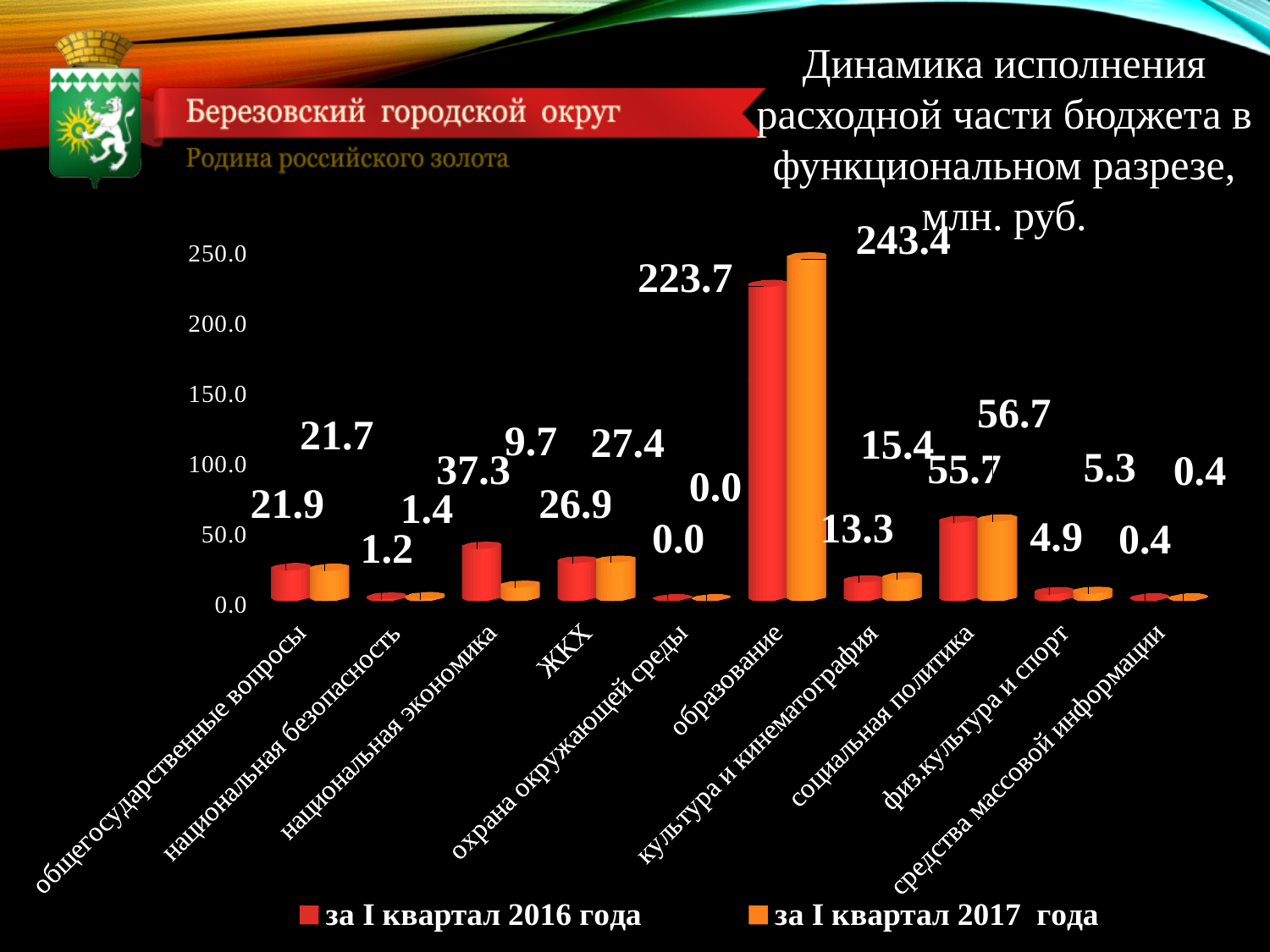
What is the difference between the за I квартал 2017 года and за I квартал 2016 года values for образование? 19.7 Is the value for социальная политика for за I квартал 2016 года greater or less than 100.0? less What is the value for социальная политика for за I квартал 2017 года? 56.7 How many series does the legend list? 2 Which category has the highest value for за I квартал 2016 года? образование How many categories are shown on the x axis? 10 For национальная экономика, which series has the larger value: за I квартал 2016 года or за I квартал 2017 года? за I квартал 2016 года What is the value for национальная экономика for за I квартал 2016 года? 37.3 What type of chart is shown on the slide? bar chart What unit is stated in the chart title? млн. руб. What is the value for образование for за I квартал 2017 года? 243.4 Which category has the lowest value for за I квартал 2017 года? охрана окружающей среды